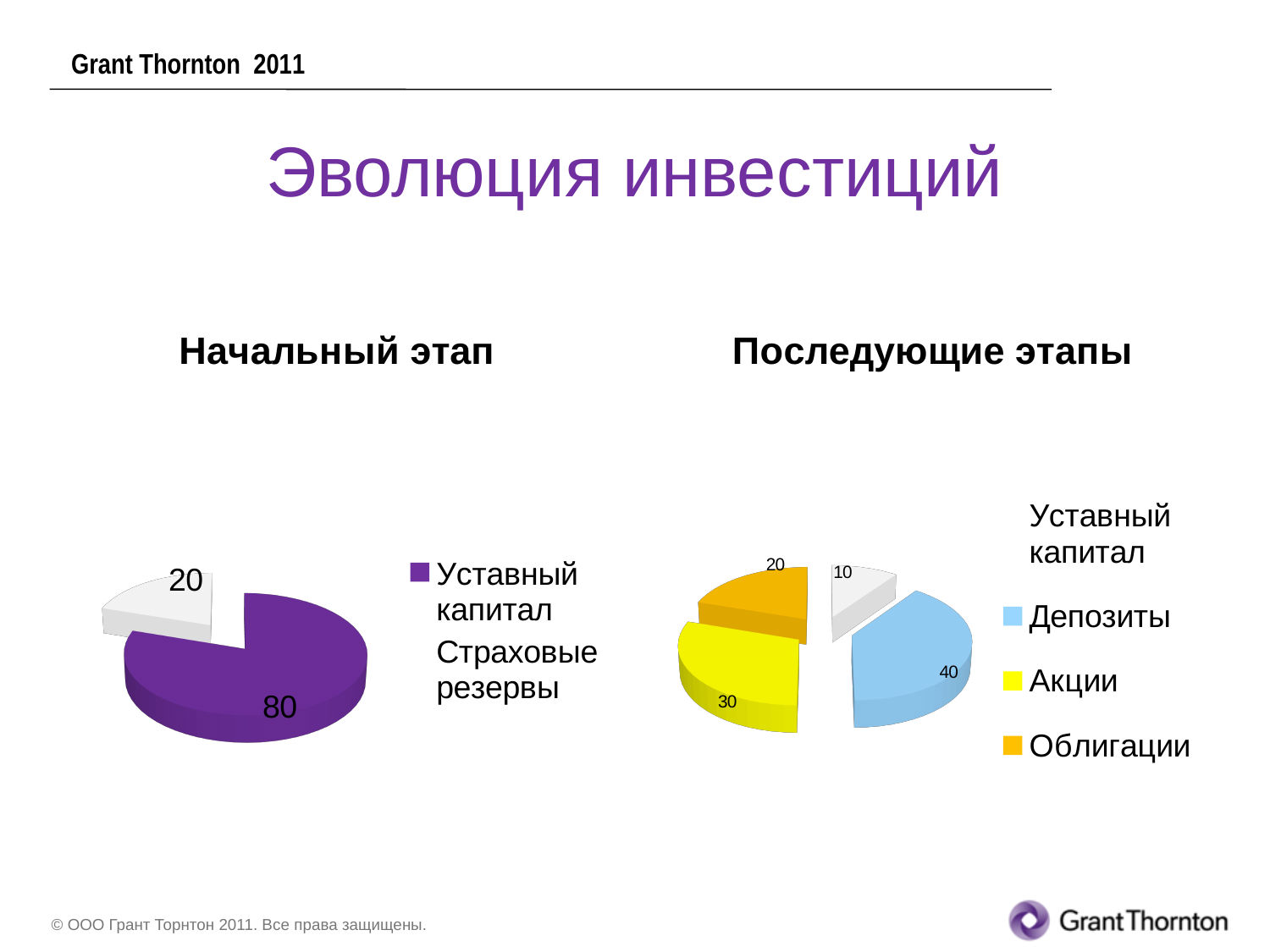
In the 'Начальный этап' pie chart, how many slices are there? 2 In the 'Начальный этап' pie chart, what is the value for Уставный капитал? 80 In the 'Последующие этапы' pie chart, which category has the smallest slice? Уставный капитал In the 'Последующие этапы' pie chart, what is the value for Депозиты? 40 In the 'Последующие этапы' pie chart, what is the value for Акции? 30 In the 'Начальный этап' pie chart, what is the difference between Уставный капитал and Страховые резервы? 60 In the 'Последующие этапы' pie chart, what is the value for Облигации? 20 What type of chart is used on the right side of the slide under 'Последующие этапы'? Pie chart In the 'Начальный этап' pie chart, what is the value for Страховые резервы? 20 In the 'Начальный этап' pie chart, which category has the largest slice? Уставный капитал In the 'Последующие этапы' pie chart, which is larger, Акции or Облигации? Акции In the 'Последующие этапы' pie chart, how many categories does the legend list? 4